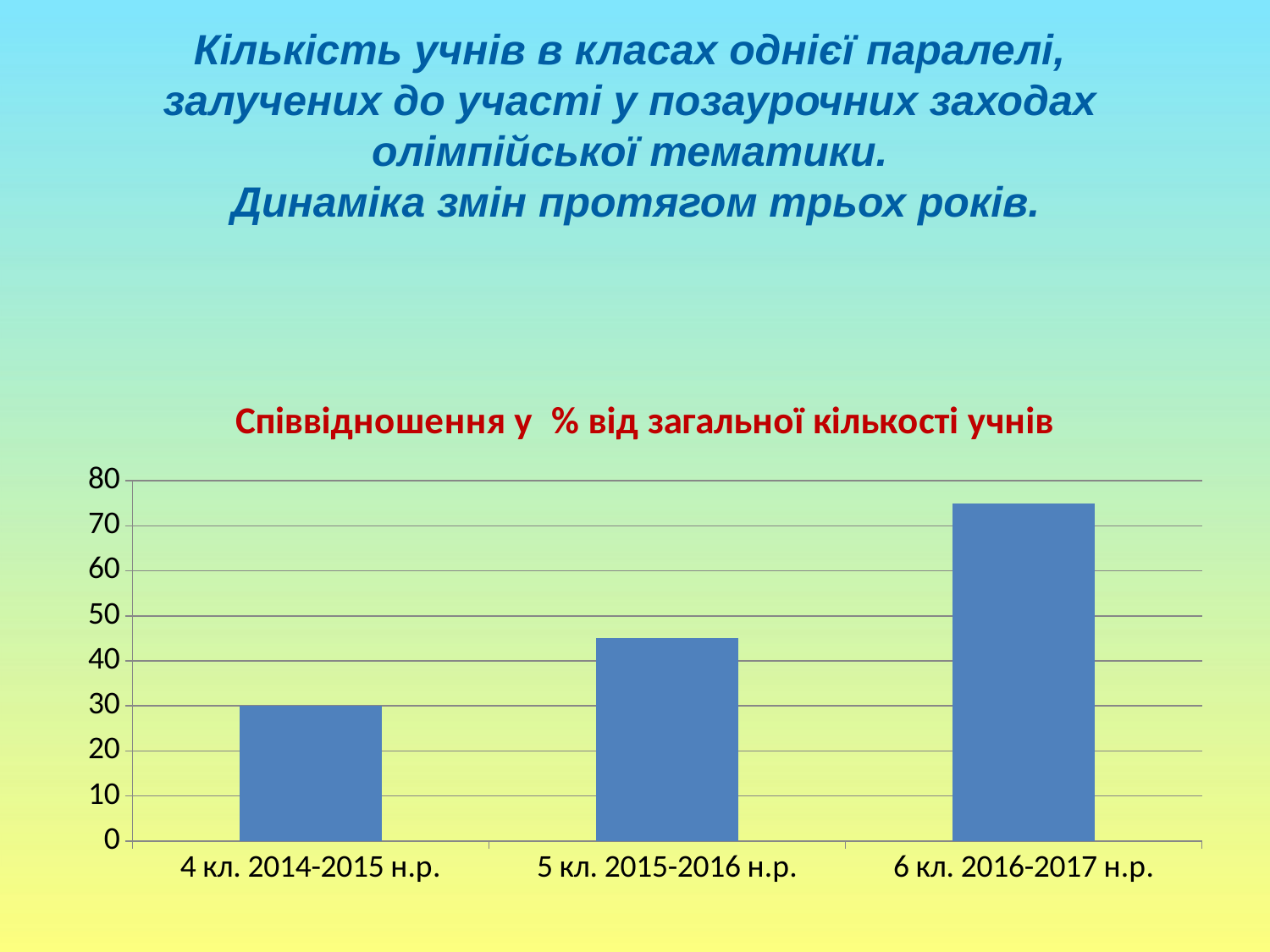
How many categories (bars) does the chart show? 3 Is the value for 5 кл. 2015-2016 н.р. greater or less than 40? greater Is the value for 6 кл. 2016-2017 н.р. greater or less than 70? greater What kind of chart is shown on the slide? bar chart Is the value for 5 кл. 2015-2016 н.р. greater or less than 50? less Do the values rise or fall from left to right along the x axis? rise Which category has the highest value? 6 кл. 2016-2017 н.р. Which is larger, the value for 5 кл. 2015-2016 н.р. or the value for 6 кл. 2016-2017 н.р.? 6 кл. 2016-2017 н.р. Which category has the lowest value? 4 кл. 2014-2015 н.р. What is the value for 4 кл. 2014-2015 н.р.? 30 What is the title of the chart? Співвідношення у % від загальної кількості учнів